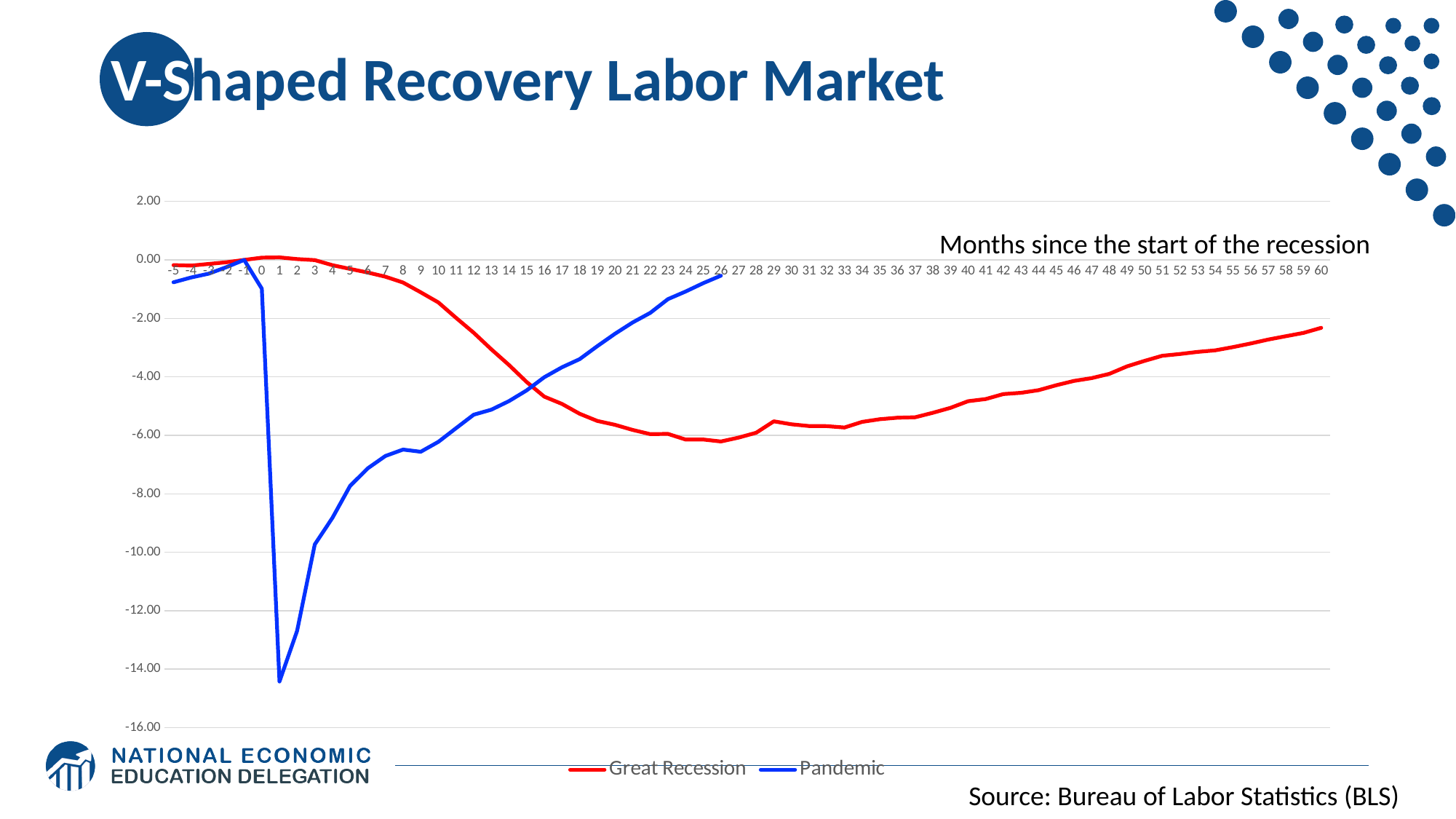
What are the two series named in the legend? Great Recession and Pandemic Is the lowest value of the Pandemic series greater or less than -12.00? less At month 10, which series has the lower value, Great Recession or Pandemic? Pandemic Does the Great Recession series rise or fall between month 30 and month 60? rise Which series reaches the lowest value on the chart? Pandemic Is the value of the Great Recession series at month 60 greater or less than -4.00? greater At month 20, which series has the higher value, Great Recession or Pandemic? Pandemic Is the lowest value of the Great Recession series greater or less than -8.00? greater How many series does the legend list? 2 What is the label given for the x axis? Months since the start of the recession What kind of chart is shown on the slide? line chart